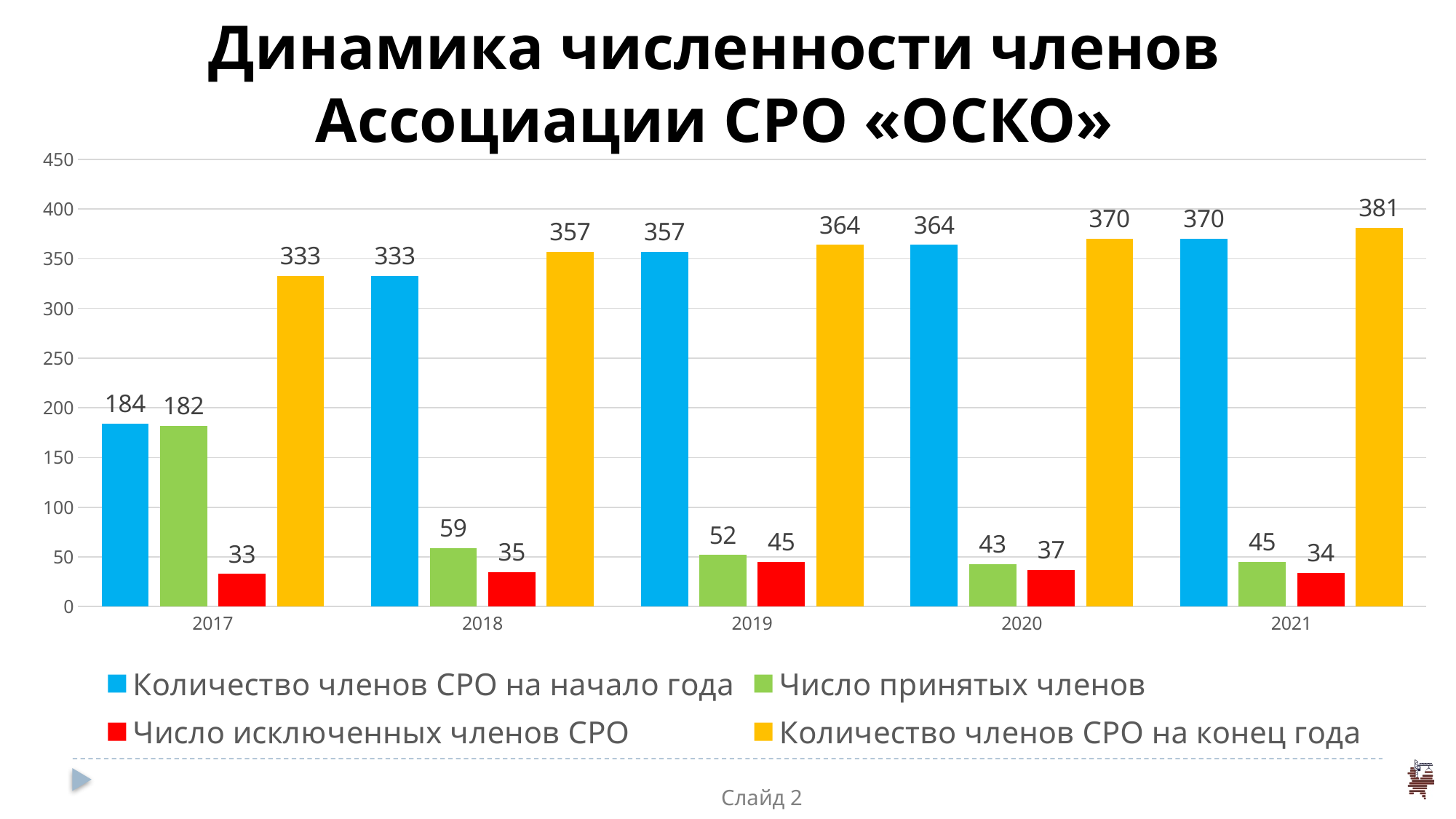
Which is larger in 2018: the number of admitted members or the number of excluded members? Number of admitted members (59) What was the number of SRO members at the start of 2017 (Количество членов СРО на начало года)? 184 In which year was the number of excluded members (Число исключенных членов СРО) lowest? 2017 What was the number of SRO members at the end of 2021 (Количество членов СРО на конец года)? 381 How many years are shown on the x axis? 5 How many series does the legend list? 4 In which year was the number of admitted members (Число принятых членов) highest? 2017 What is the difference between the number of members at the end of 2021 and at the start of 2021? 11 What type of chart is shown on the slide? Bar chart How many members were excluded (Число исключенных членов СРО) in 2020? 37 How many members were admitted (Число принятых членов) in 2019? 52 Does the number of SRO members at the end of the year rise or fall from 2017 to 2021? Rises